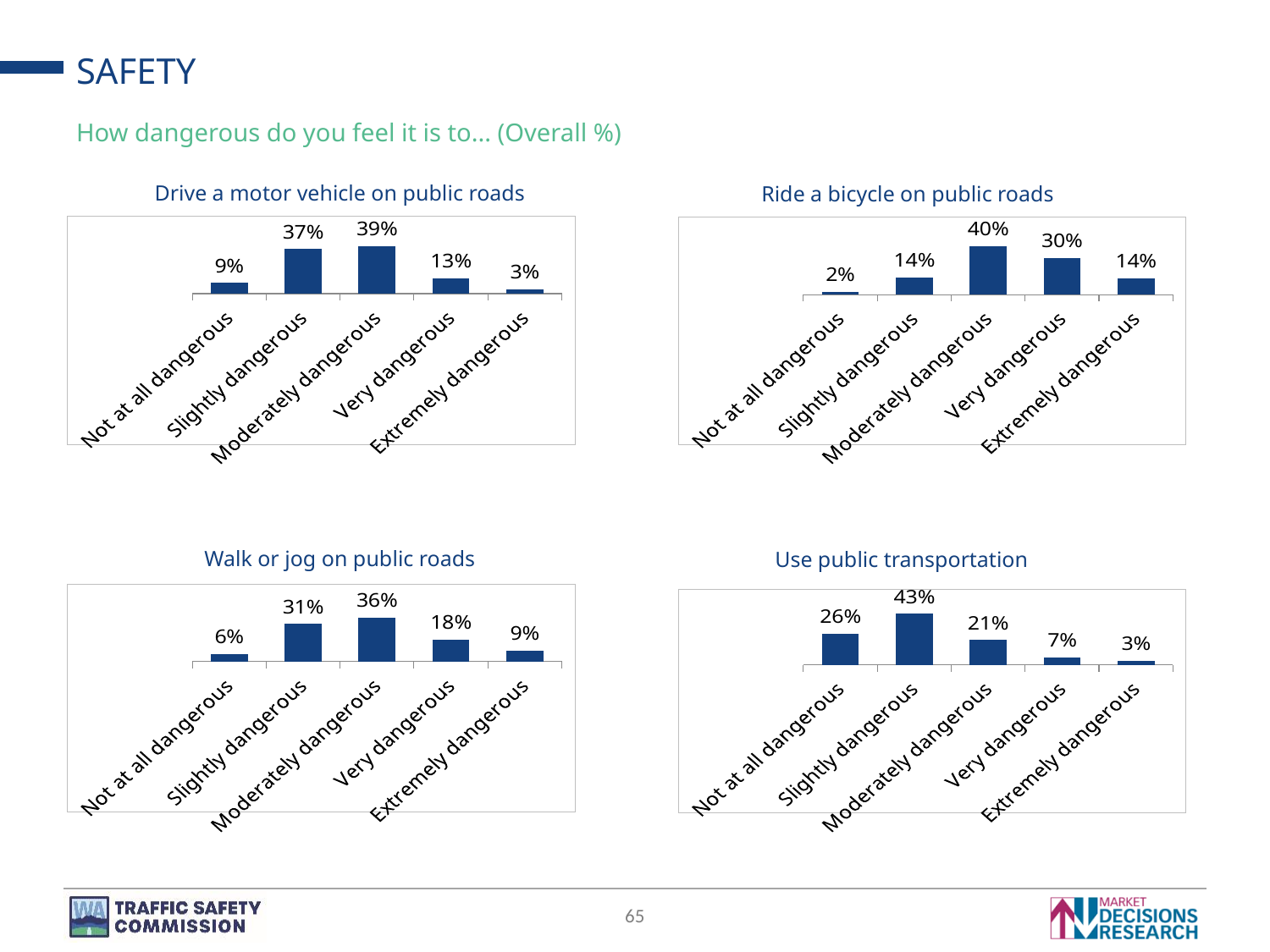
In the 'Walk or jog on public roads' chart, what is the difference between 'Moderately dangerous' and 'Very dangerous'? 18% In the 'Use public transportation' chart, which category has the highest value? Slightly dangerous What is the title of the chart in the top-right position of the slide? Ride a bicycle on public roads In the 'Use public transportation' chart, is the value for 'Not at all dangerous' larger or smaller than the value for 'Moderately dangerous'? larger In the 'Drive a motor vehicle on public roads' chart, what is the difference between 'Slightly dangerous' and 'Extremely dangerous'? 34% In the 'Use public transportation' chart, what is the value for 'Extremely dangerous'? 3% In the 'Walk or jog on public roads' chart, which category has the lowest value? Not at all dangerous How many categories are shown in the 'Walk or jog on public roads' chart? 5 In the 'Ride a bicycle on public roads' chart, what is the value for 'Very dangerous'? 30% In the 'Drive a motor vehicle on public roads' chart, what is the value for 'Moderately dangerous'? 39% In the 'Ride a bicycle on public roads' chart, which category has the lowest value? Not at all dangerous What type of chart is the 'Drive a motor vehicle on public roads' chart? bar chart